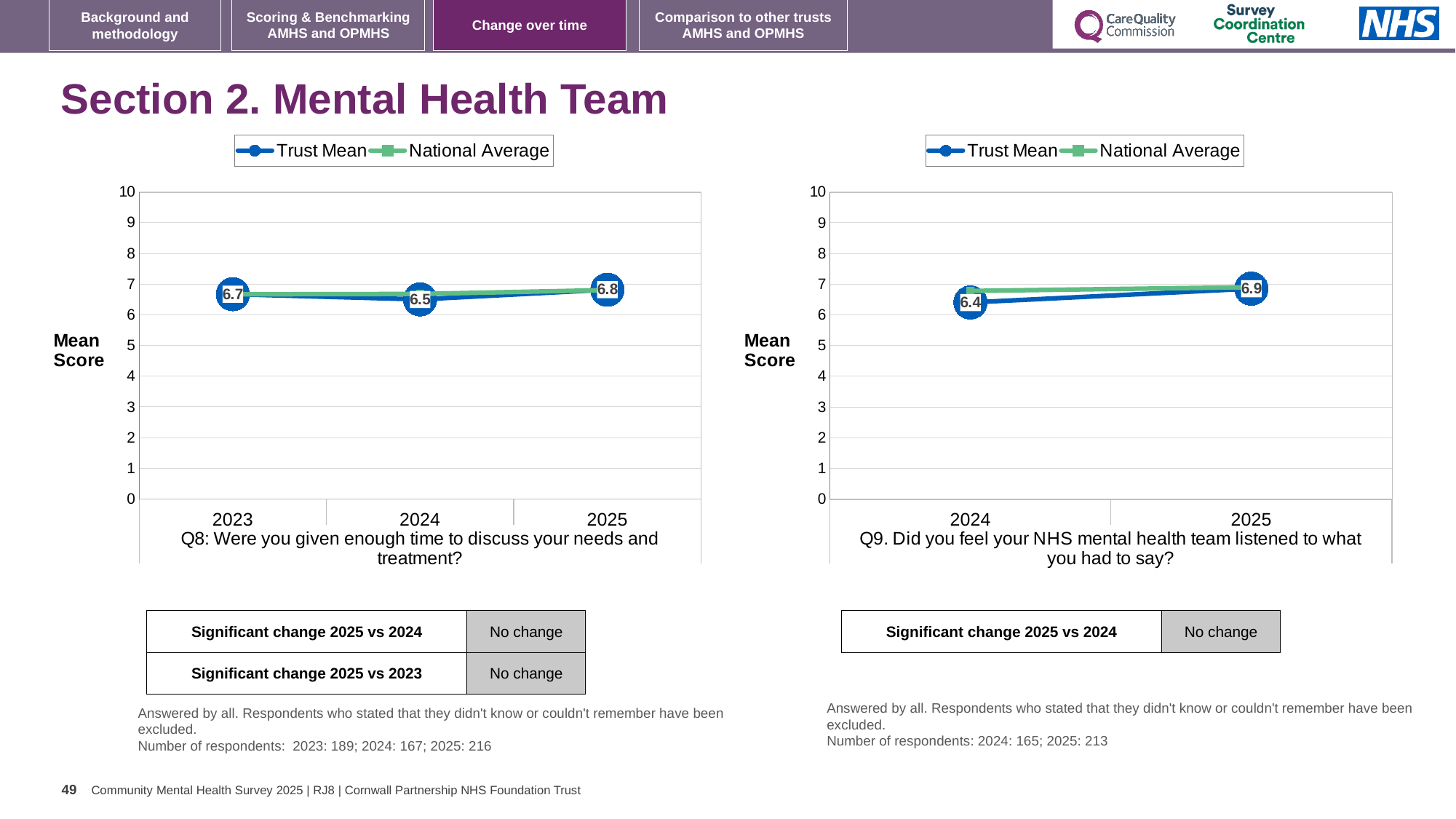
On the Q8 chart (left), what is the Trust Mean score for 2023? 6.7 How many years are plotted on the Q9 chart (right)? 2 On the Q8 chart (left), what is the Trust Mean score for 2024? 6.5 On the Q9 chart (right), what is the Trust Mean score for 2025? 6.9 On the Q9 chart (right), what is the Trust Mean score for 2024? 6.4 On the Q8 chart (left), which year has the highest Trust Mean score? 2025 What type of chart is the Q9 chart (right)? Line chart On the Q9 chart (right), what is the difference between the Trust Mean scores for 2025 and 2024? 0.5 On the Q8 chart (left), which year has the lowest Trust Mean score? 2024 On the Q8 chart (left), is the Trust Mean score for 2025 greater or less than 6? greater How many series does the legend of the Q8 chart (left) list? 2 On the Q8 chart (left), what is the Trust Mean score for 2025? 6.8